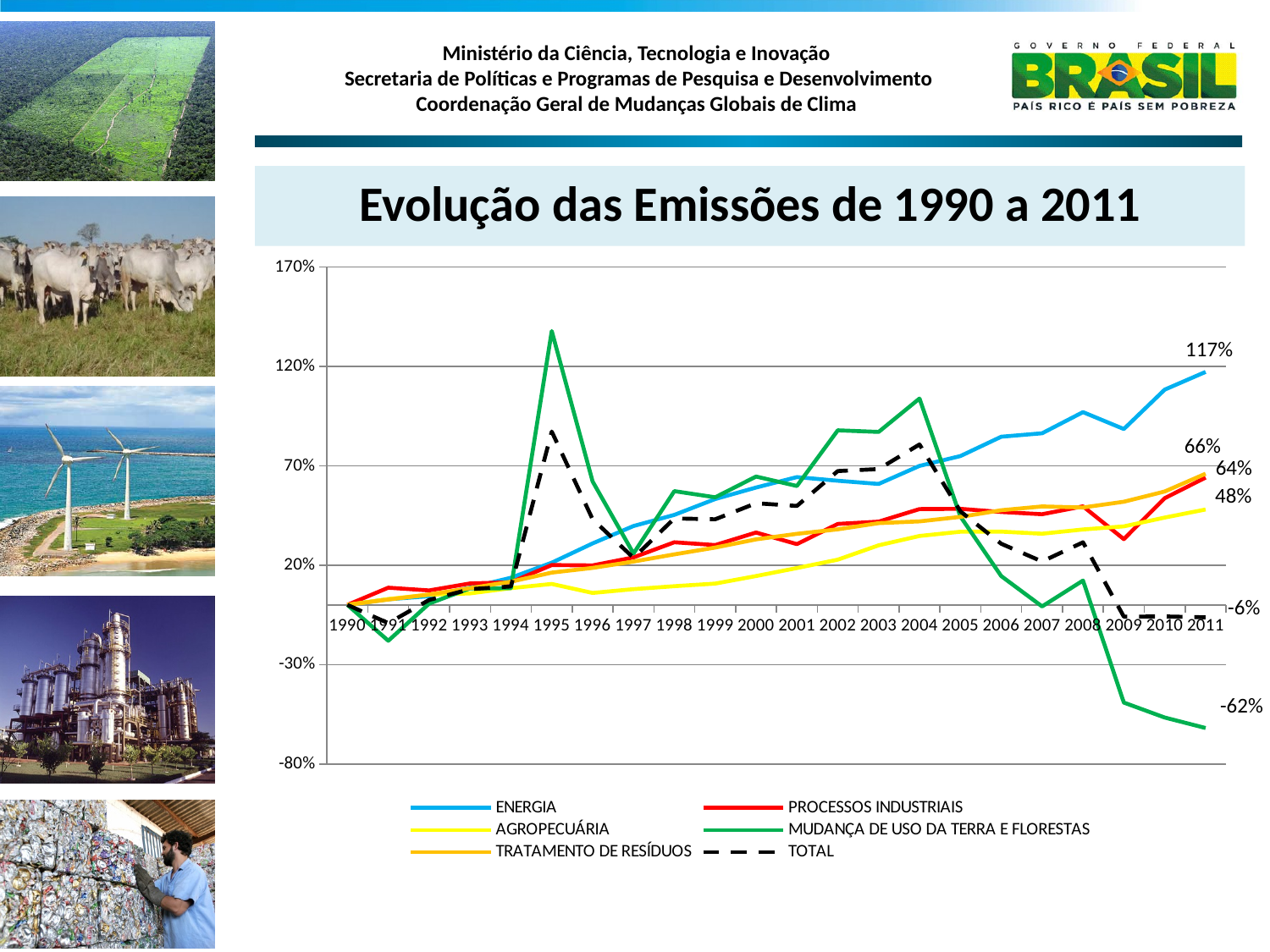
What is the value for AGROPECUÁRIA in 2011? 48% Which series has the lowest value in 2011? MUDANÇA DE USO DA TERRA E FLORESTAS How many series does the legend list? 6 What kind of chart is shown on the slide? Line chart What is the value for ENERGIA in 2011? 117% What is the value for MUDANÇA DE USO DA TERRA E FLORESTAS in 2011? -62% What is the difference between the 2011 values for ENERGIA and AGROPECUÁRIA? 69 percentage points What is the value for TOTAL in 2011? -6% How many years are shown on the x axis? 22 Which series has the highest value in 2011? ENERGIA What is the title of the chart? Evolução das Emissões de 1990 a 2011 Is the value for MUDANÇA DE USO DA TERRA E FLORESTAS in 1995 greater or less than 120%? greater